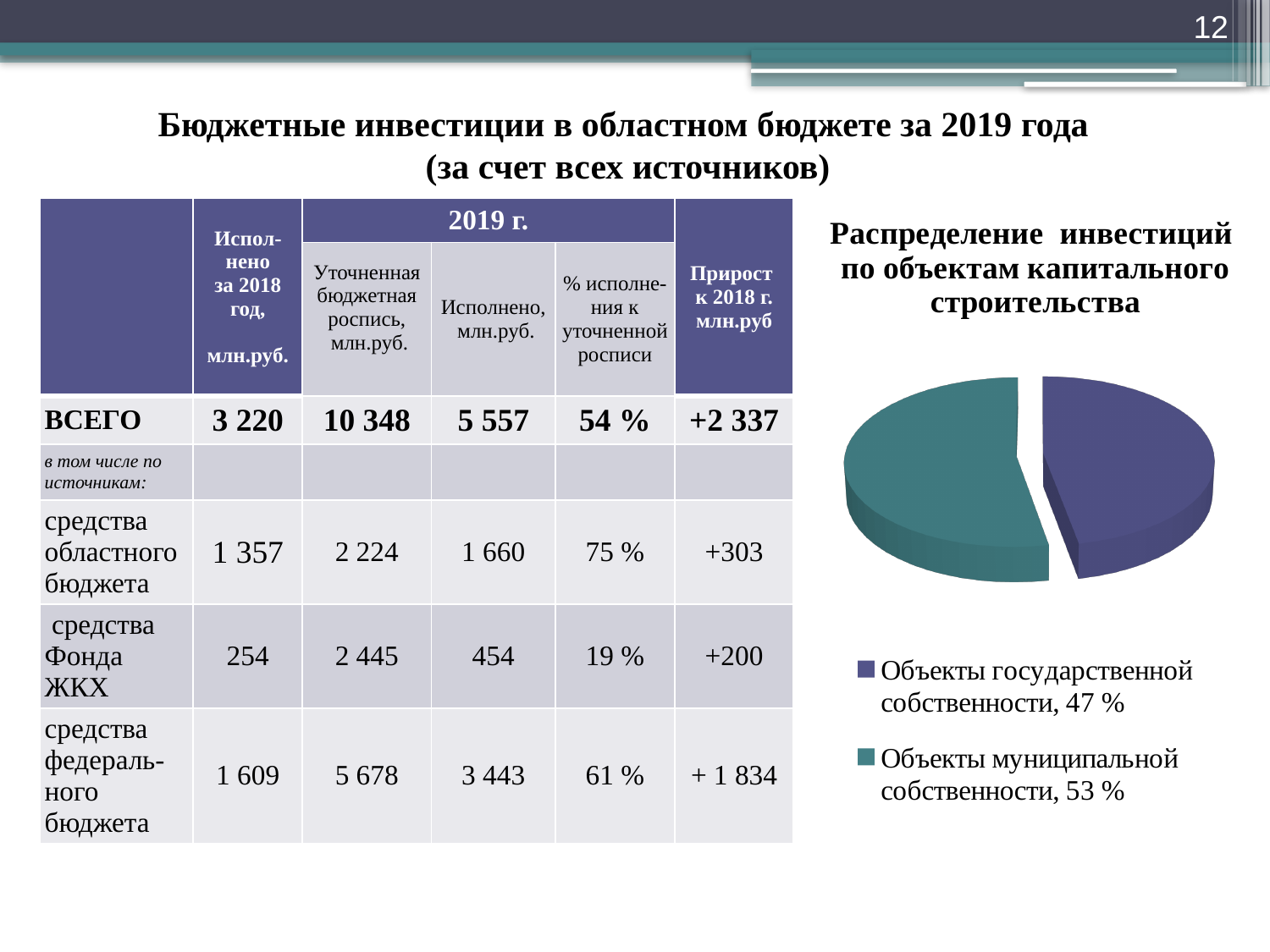
Which is larger: the share for Объекты государственной собственности or for Объекты муниципальной собственности? Объекты муниципальной собственности How many slices does the pie chart have? 2 What kind of chart is shown on the slide? pie chart Is the share for Объекты государственной собственности greater or less than 50 %? less What is the title of the pie chart? Распределение инвестиций по объектам капитального строительства How many entries does the legend of the pie chart list? 2 Which slice of the pie chart is the largest? Объекты муниципальной собственности What colour is the slice for Объекты муниципальной собственности? teal (green) Which slice of the pie chart is the smallest? Объекты государственной собственности What share of the pie is Объекты государственной собственности? 47 % What is the difference in percentage points between Объекты муниципальной собственности and Объекты государственной собственности? 6 % What share of the pie is Объекты муниципальной собственности? 53 %